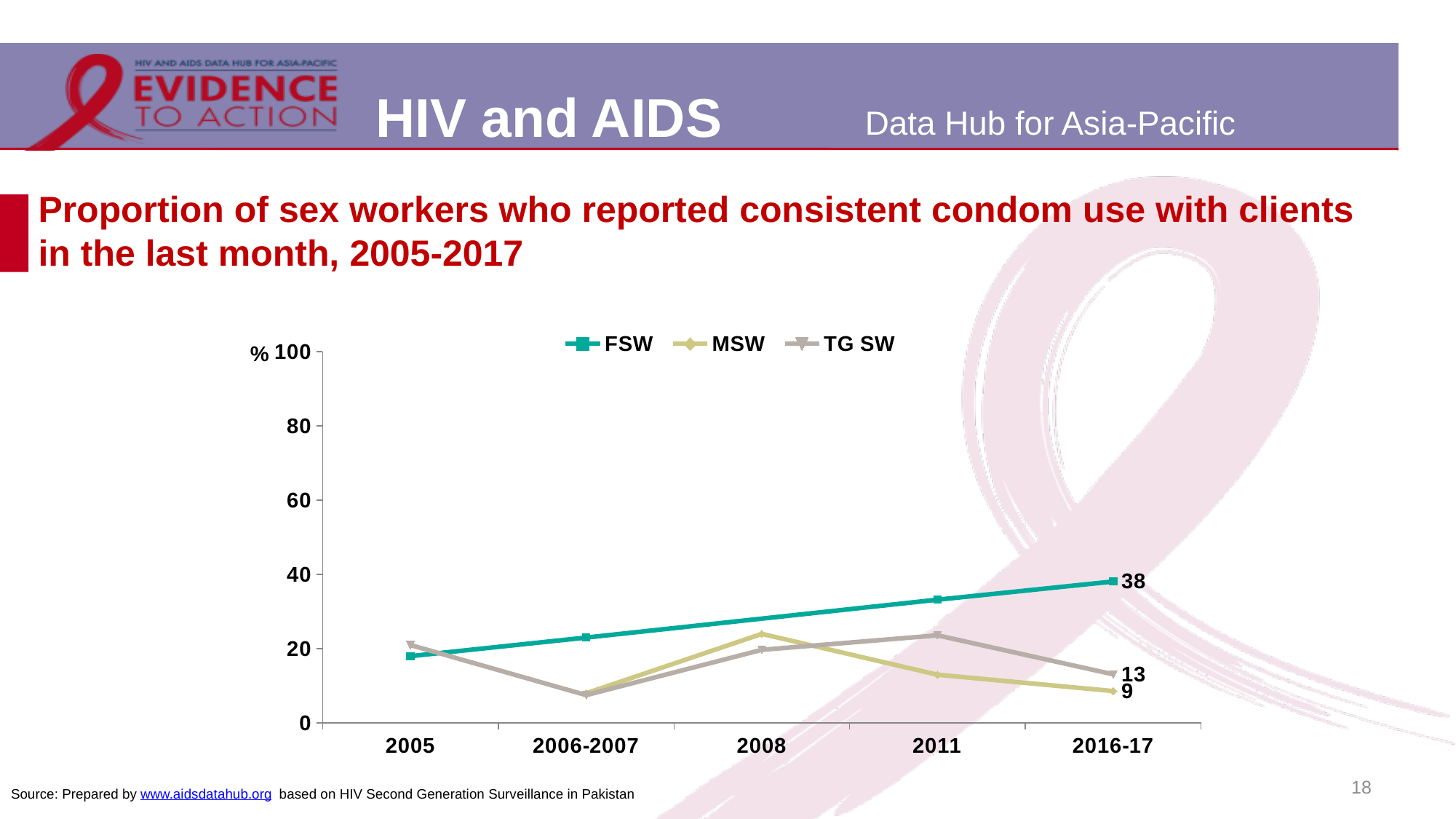
What is the value for MSW in 2016-17? 9 Is the value for MSW in 2006-2007 greater or less than 20? less What kind of chart is shown on the slide? line chart Which series has the highest value in 2016-17? FSW What is the value for FSW in 2016-17? 38 What is the value for TG SW in 2016-17? 13 What is the difference between the TG SW and MSW values in 2016-17? 4 In 2016-17, which is larger, the value for TG SW or the value for MSW? TG SW Does the FSW line rise or fall from 2005 to 2016-17? rises How many series does the legend list? 3 How many time points are shown on the x axis? 5 What is the difference between the FSW and MSW values in 2016-17? 29